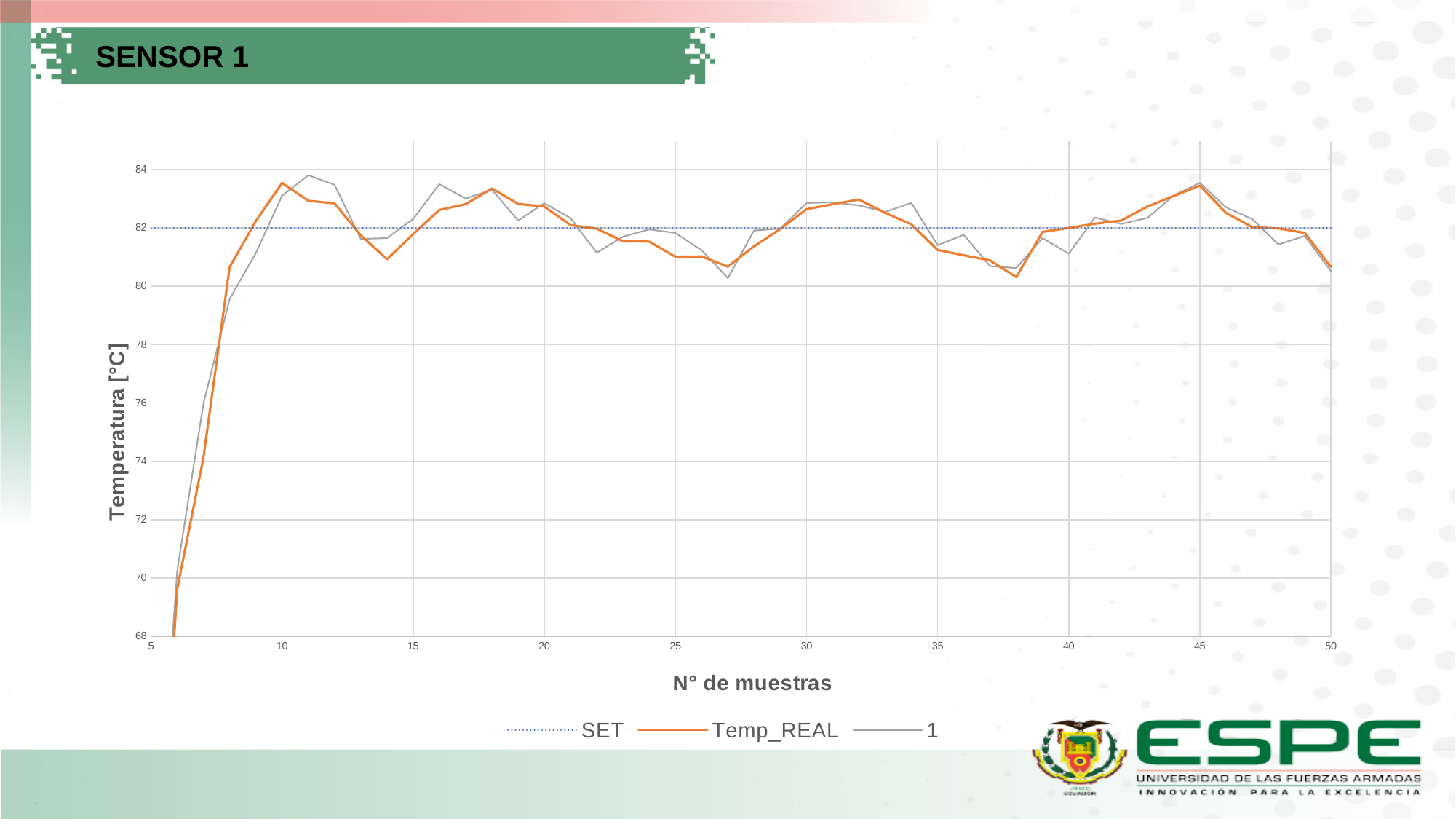
How many series does the legend list? 3 Is the Temp_REAL value at sample 45 greater or less than 82? greater Which is larger: the Temp_REAL value at sample 10 or at sample 14? Sample 10 Is the Temp_REAL value at sample 10 greater or less than 82? greater What type of chart is shown on the slide? Line chart What is the title of the x axis? N° de muestras What value does the SET line hold across the chart? 82 Is the Temp_REAL value at sample 14 greater or less than 82? less What is the title of the y axis? Temperatura [°C] Does Temp_REAL rise or fall between sample 5 and sample 10? Rise